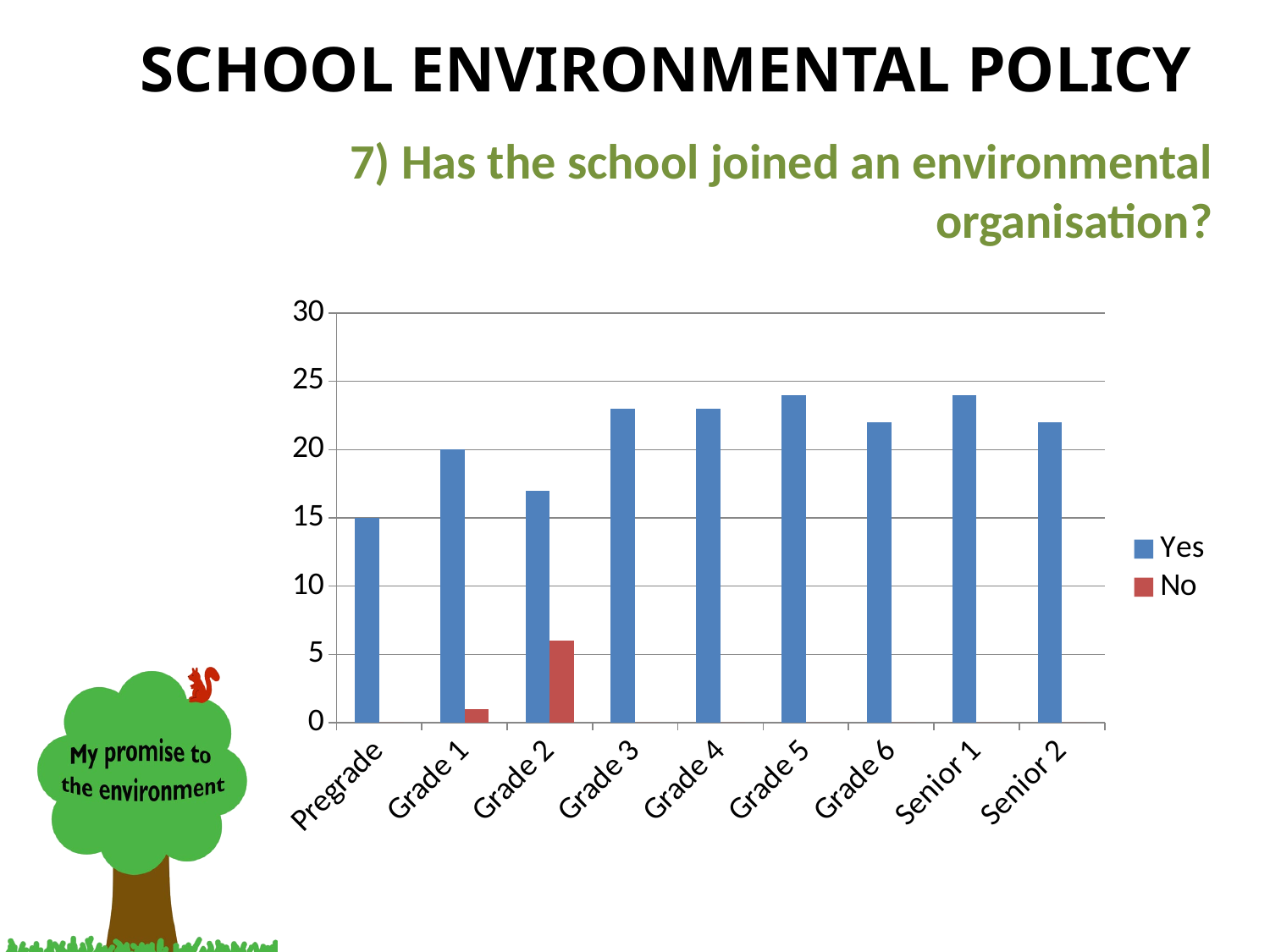
Is the 'No' value for Grade 2 greater or less than 10? less What kind of chart is shown on the slide? bar chart What is the 'Yes' value for Pregrade? 15 How many grade categories are shown on the x axis of the chart? 9 Which category has the lowest 'Yes' value? Pregrade Which category shows the largest 'No' value? Grade 2 What are the two series named in the chart's legend? Yes and No Which is larger, the 'Yes' value for Grade 1 or the 'Yes' value for Grade 2? Grade 1 Is the 'Yes' value for Grade 3 greater or less than 20? greater What is the 'Yes' value for Grade 1? 20 How many series does the chart's legend list? 2 Is the 'Yes' value for Grade 2 greater or less than 20? less